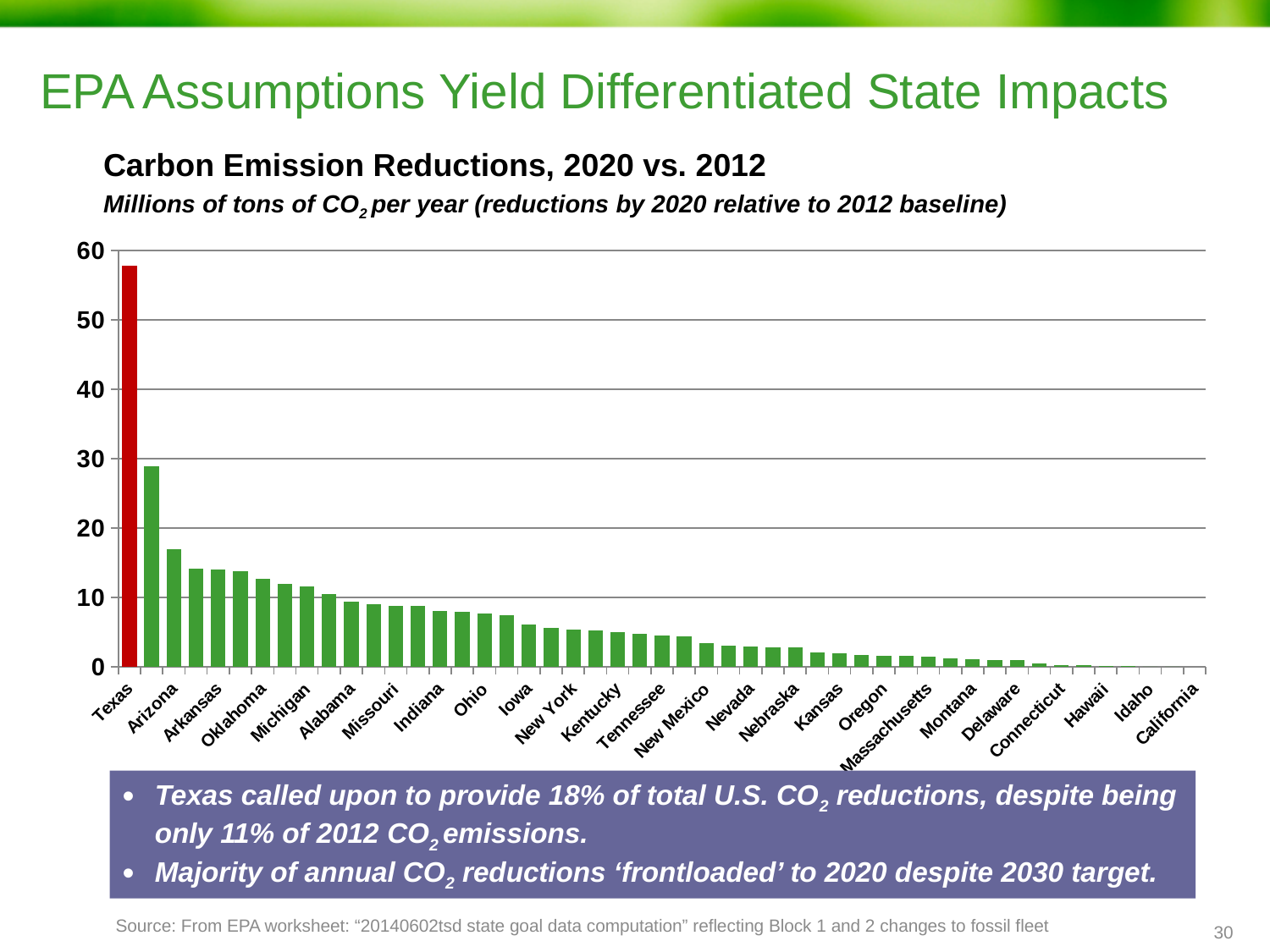
What is the title of the chart? Carbon Emission Reductions, 2020 vs. 2012 What kind of chart is shown on the slide? bar chart Is the value for Arkansas greater or less than 10? greater Is the value for Ohio greater or less than 10? less Which has a larger carbon emission reduction, Texas or Arizona? Texas Is the value for Kansas greater or less than 10? less Which state's bar is coloured red rather than green? Texas Do the values rise or fall moving from left to right along the x axis? fall Which state has the highest carbon emission reduction in the chart? Texas Which has a larger carbon emission reduction, Arkansas or Ohio? Arkansas